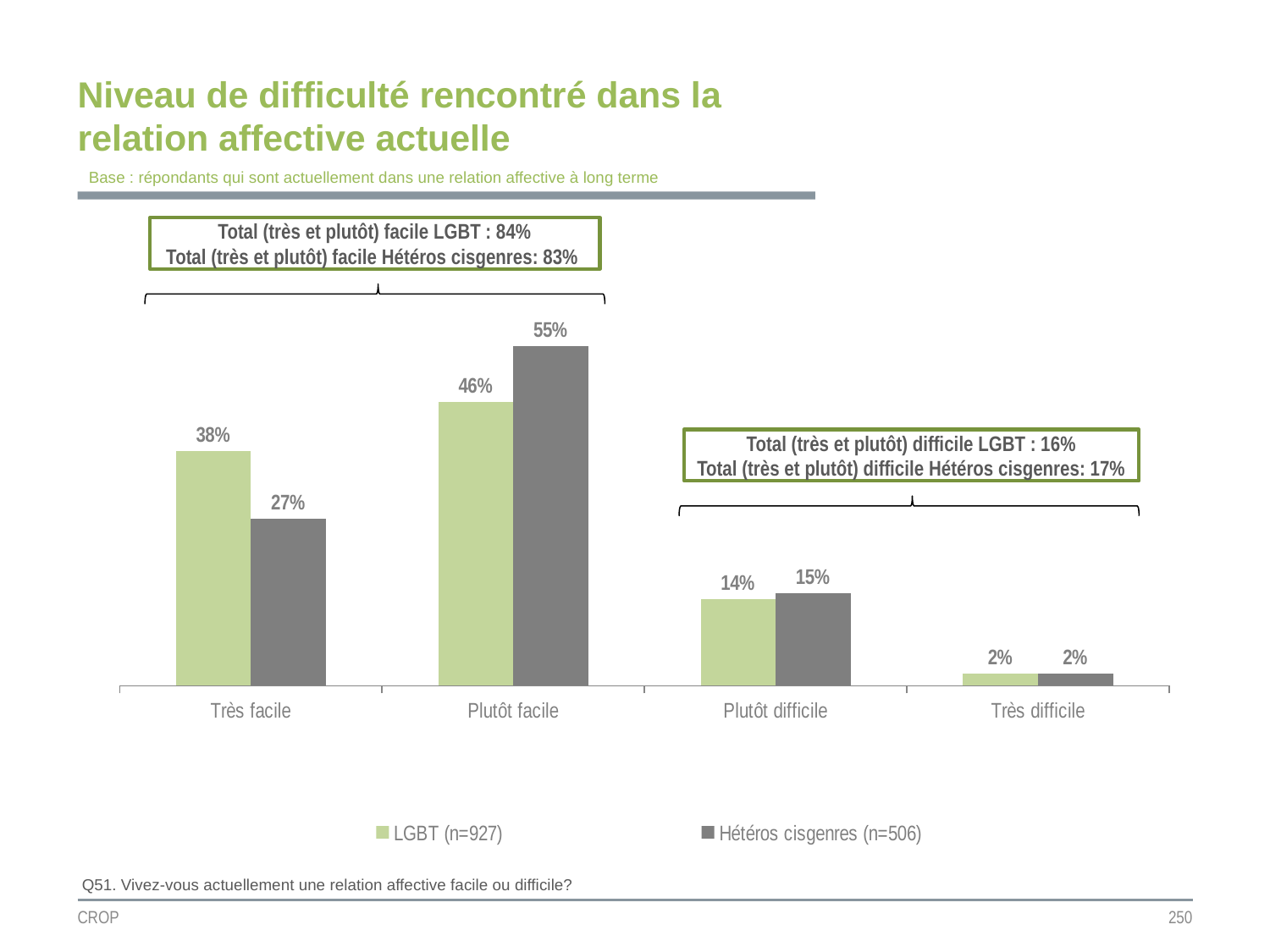
How many series does the legend list? 2 Which category has the lowest value for LGBT? Très difficile How many categories are shown on the x axis? 4 What is the difference between the LGBT and Hétéros cisgenres values in the 'Très facile' category? 11 percentage points What is the value for LGBT in the 'Très facile' category? 38% What kind of chart is shown on the slide? Bar chart What sample size is shown in the legend for Hétéros cisgenres? n=506 What is the value for LGBT in the 'Plutôt difficile' category? 14% According to the annotation box, what is the total (très et plutôt) facile for LGBT? 84% What is the value for Hétéros cisgenres in the 'Plutôt facile' category? 55% In the 'Plutôt facile' category, which series has the larger value, LGBT or Hétéros cisgenres? Hétéros cisgenres Which category has the highest value for Hétéros cisgenres? Plutôt facile